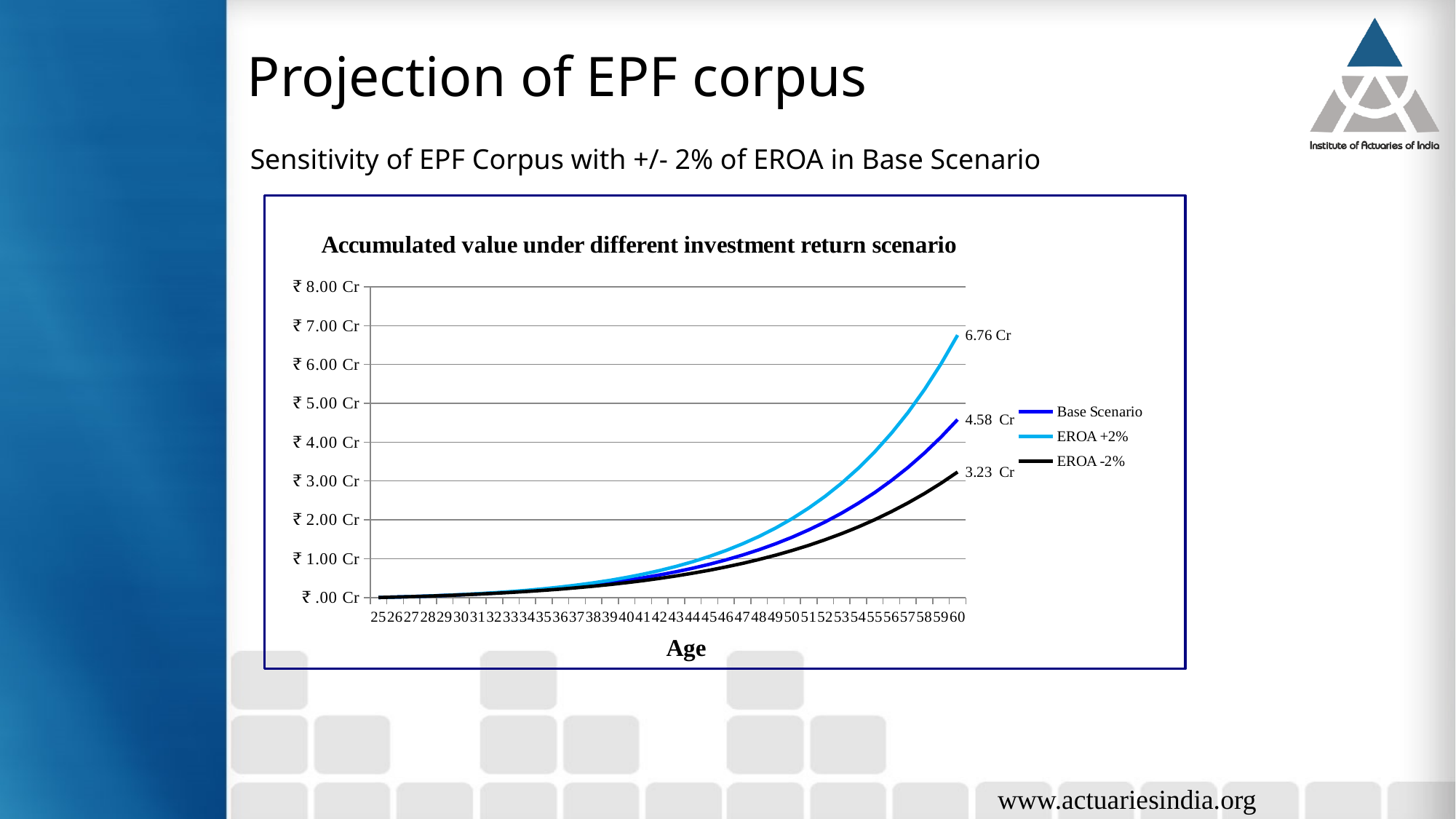
Is the Base Scenario value at age 40 greater or less than 1.00 Cr? less Which scenario has the lowest accumulated value at age 60? EROA -2% What is the accumulated value at age 60 under the Base Scenario? 4.58 Cr What is the difference between the EROA +2% and Base Scenario values at age 60? 2.18 Cr What is the title of the chart? Accumulated value under different investment return scenario Which scenario has the highest accumulated value at age 60? EROA +2% What is the accumulated value at age 60 under the EROA -2% scenario? 3.23 Cr Do the accumulated values rise or fall as age increases? rise What kind of chart is shown on the slide? line chart How many series does the legend list? 3 What is the accumulated value at age 60 under the EROA +2% scenario? 6.76 Cr What is the difference between the Base Scenario and EROA -2% values at age 60? 1.35 Cr